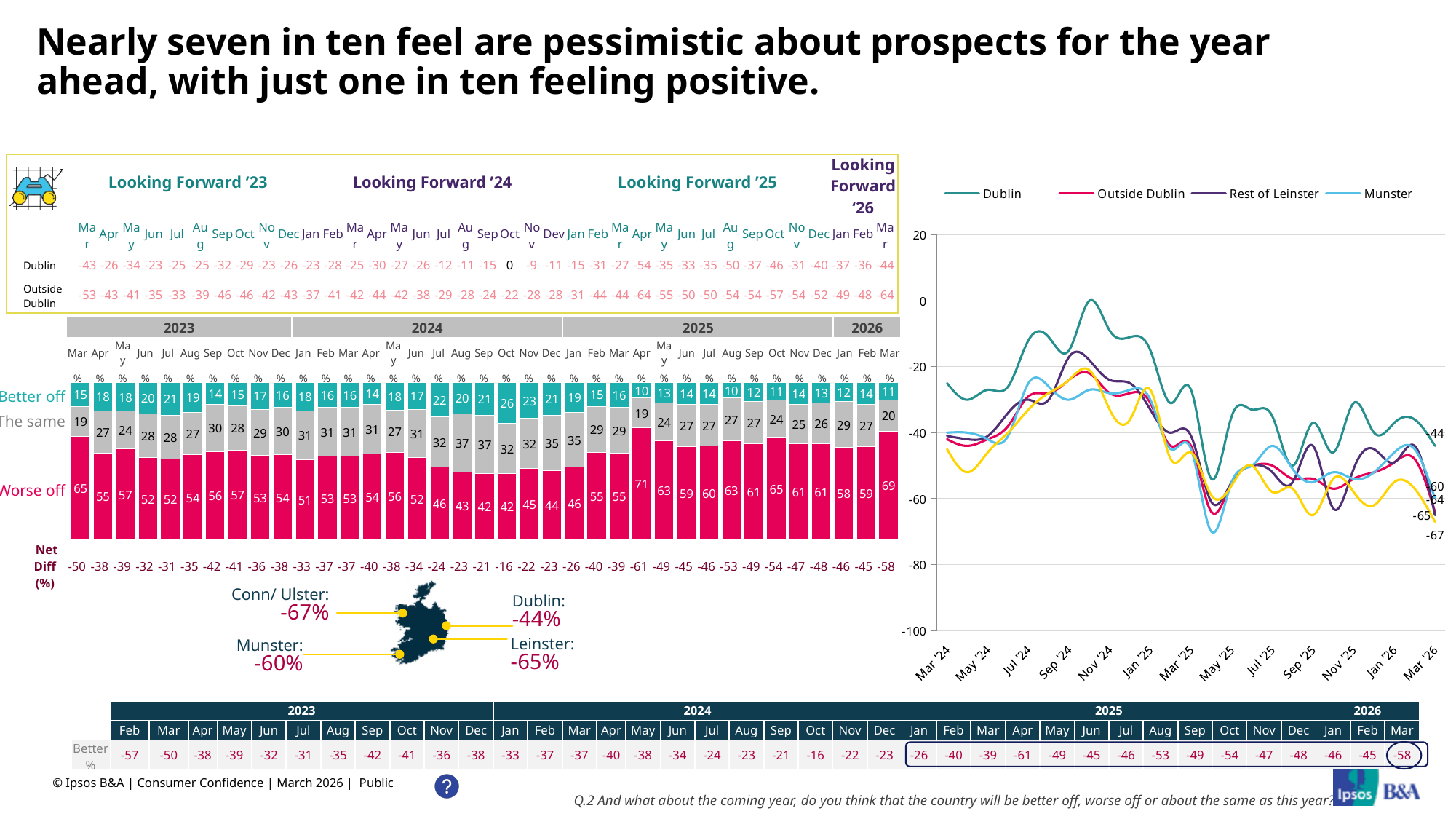
In the stacked bar chart, which month has the highest 'Worse off' percentage? Apr 2025 In the stacked bar chart, which is larger: the 'Worse off' percentage in Apr 2025 or in Jan 2025? Apr 2025 In the stacked bar chart, what is the total of the three segments for Mar 2026? 100 In the stacked bar chart, what percentage said 'Better off' in Mar 2026? 11 In the stacked bar chart, which month has the highest 'Better off' percentage? Oct 2024 In the stacked bar chart, what percentage said 'The same' in Feb 2026? 27 What kind of chart is shown on the right of the slide? Line chart How many series does the legend of the line chart on the right list? 4 In the line chart on the right, what is the value for Dublin at Mar '26? -44 What is the Net Diff (%) shown for Mar 2026? -58 In the stacked bar chart, what percentage said 'Worse off' in Mar 2026? 69 In the stacked bar chart, what is the difference between the 'Worse off' percentages for Mar 2026 and Feb 2026? 10